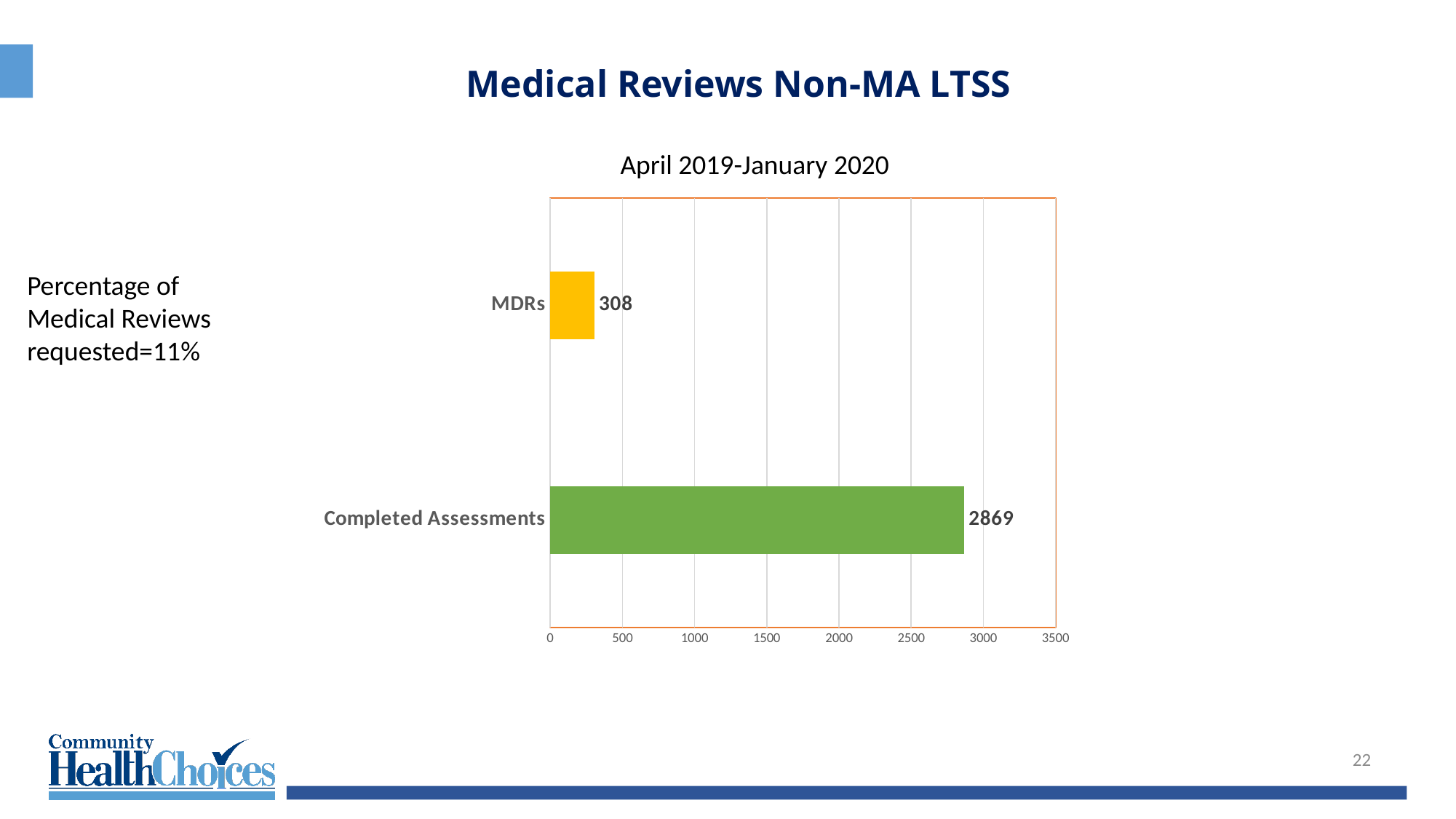
What colour is the bar for Completed Assessments? green Is the value for MDRs greater or less than 500? less Is the value for Completed Assessments greater or less than 2500? greater What kind of chart is shown on the slide? bar chart How many categories are shown in the chart? 2 Which category has the highest value? Completed Assessments Which category has the lowest value? MDRs What is the difference between Completed Assessments and MDRs? 2561 What is the value for Completed Assessments? 2869 What is the value for MDRs? 308 What is the title of the chart? April 2019-January 2020 Which is larger, the value for MDRs or the value for Completed Assessments? Completed Assessments